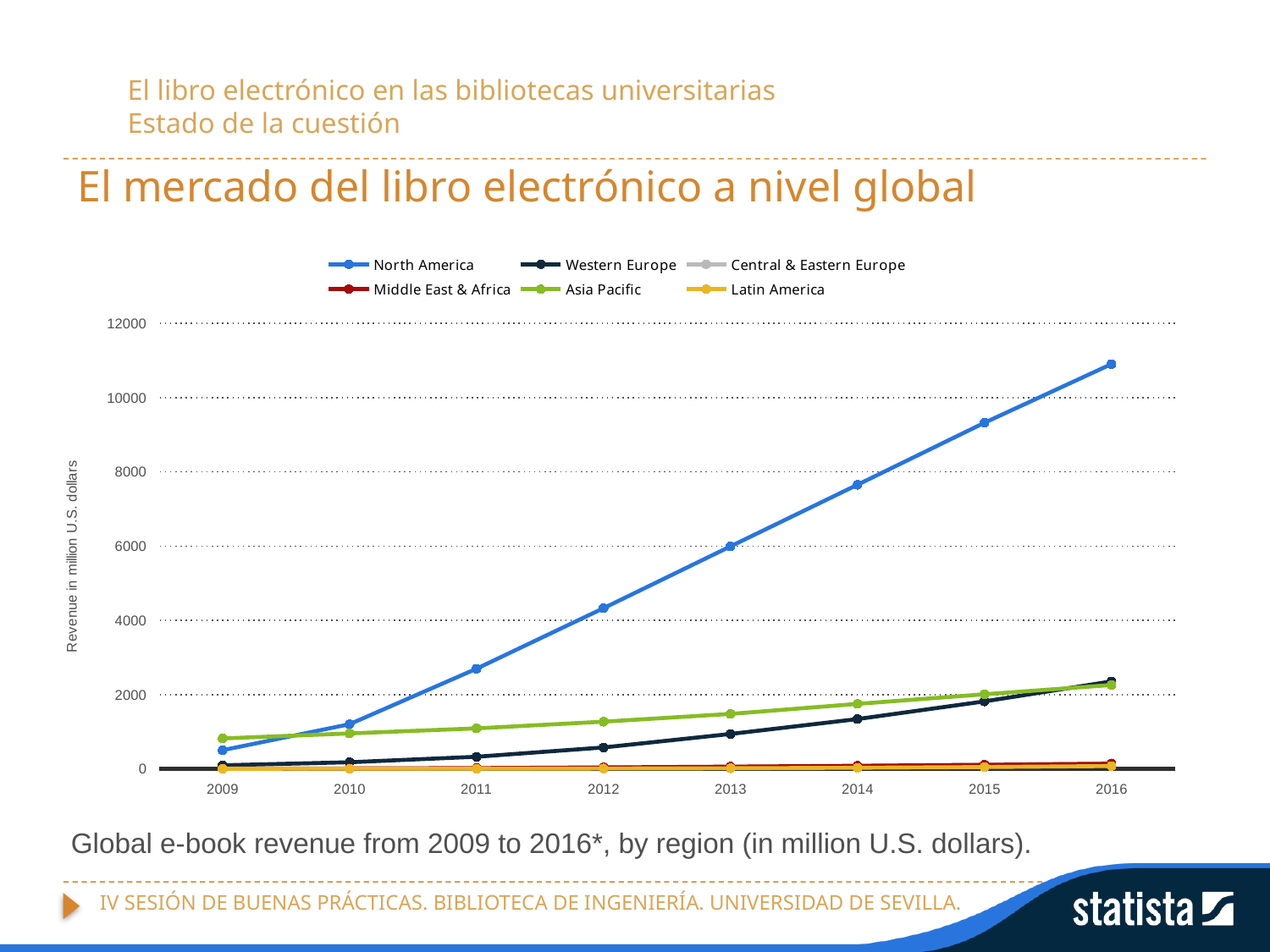
Does the revenue for North America rise or fall from 2009 to 2016? Rise Is the value for Asia Pacific in 2009 greater or less than 2000? less Which is larger in 2009, the value for Asia Pacific or the value for Western Europe? Asia Pacific Is the value for North America in 2016 greater or less than 10000? greater What is the label on the y axis? Revenue in million U.S. dollars Is the value for North America in 2012 greater or less than 4000? greater How many years are plotted along the x axis? 8 What kind of chart is shown on the slide? Line chart Which region has the highest revenue in 2016? North America How many series does the legend list? 6